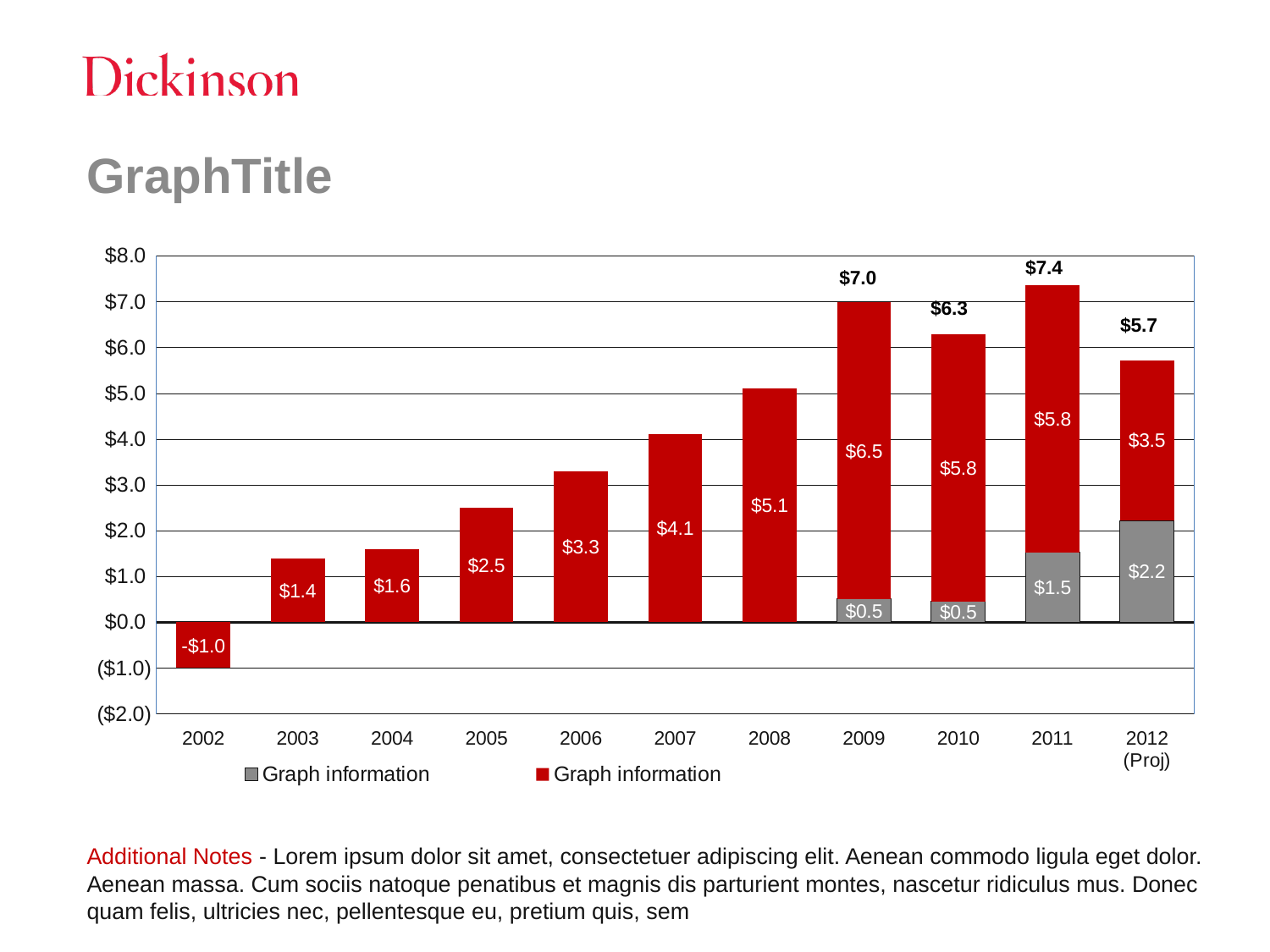
Which year has the highest total bar? 2011 How many years are shown on the x axis? 11 Which year has the lowest value? 2002 Which is larger, the value for 2005 or the value for 2004? 2005 What is the value of the red segment for 2008? $5.1 What is the total of the stacked bar for 2012 (Proj)? $5.7 What kind of chart is shown on the slide? Stacked bar chart What is the value of the red segment for 2012 (Proj)? $3.5 How many series does the legend list? 2 What is the difference between the red segment values for 2009 and 2010? $0.7 What is the total of the stacked bar for 2011? $7.4 What is the value of the grey segment for 2011? $1.5